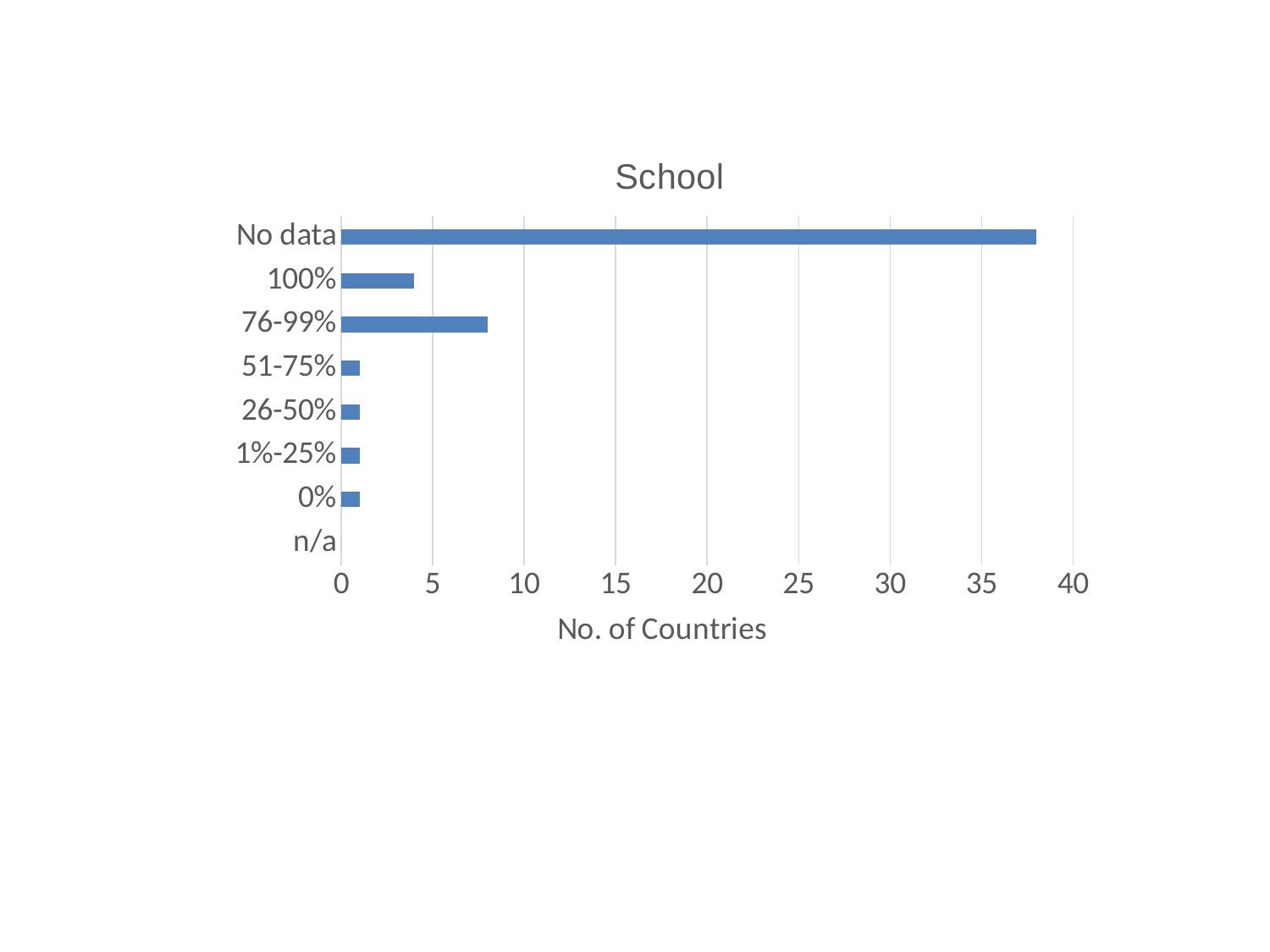
What kind of chart is shown on the slide? bar chart Which category has the highest number of countries? No data What is the label of the horizontal axis? No. of Countries Is the value for No data greater or less than 35? greater Which category has no visible bar in the chart? n/a What is the title of the chart? School Is the value for 100% greater or less than 5? less How many categories are shown on the vertical axis of the chart? 8 Is the value for 76-99% greater or less than 5? greater Which has more countries, No data or 76-99%? No data Which has more countries, 76-99% or 100%? 76-99%